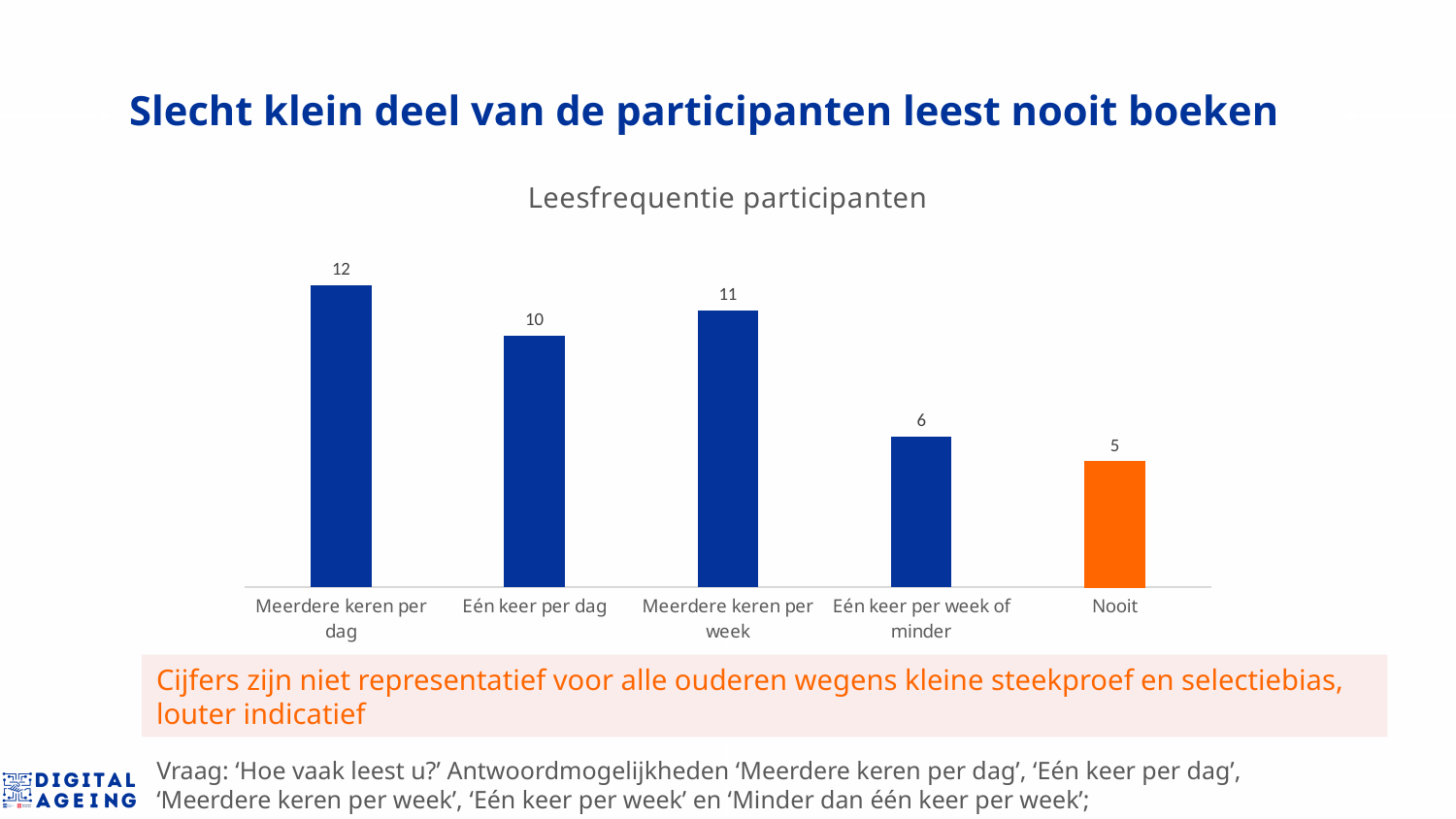
What is the difference between 'Meerdere keren per week' and 'Eén keer per dag'? 1 What is the value for 'Meerdere keren per dag'? 12 How many categories are shown in the chart? 5 Which category has the lowest value? Nooit What is the title of the chart? Leesfrequentie participanten What is the difference between 'Meerdere keren per dag' and 'Nooit'? 7 Which category has the highest value? Meerdere keren per dag Which bar is coloured orange instead of blue? Nooit What is the value for 'Nooit'? 5 What kind of chart is this? Bar chart Which is larger: 'Eén keer per dag' or 'Eén keer per week of minder'? Eén keer per dag What is the value for 'Eén keer per week of minder'? 6